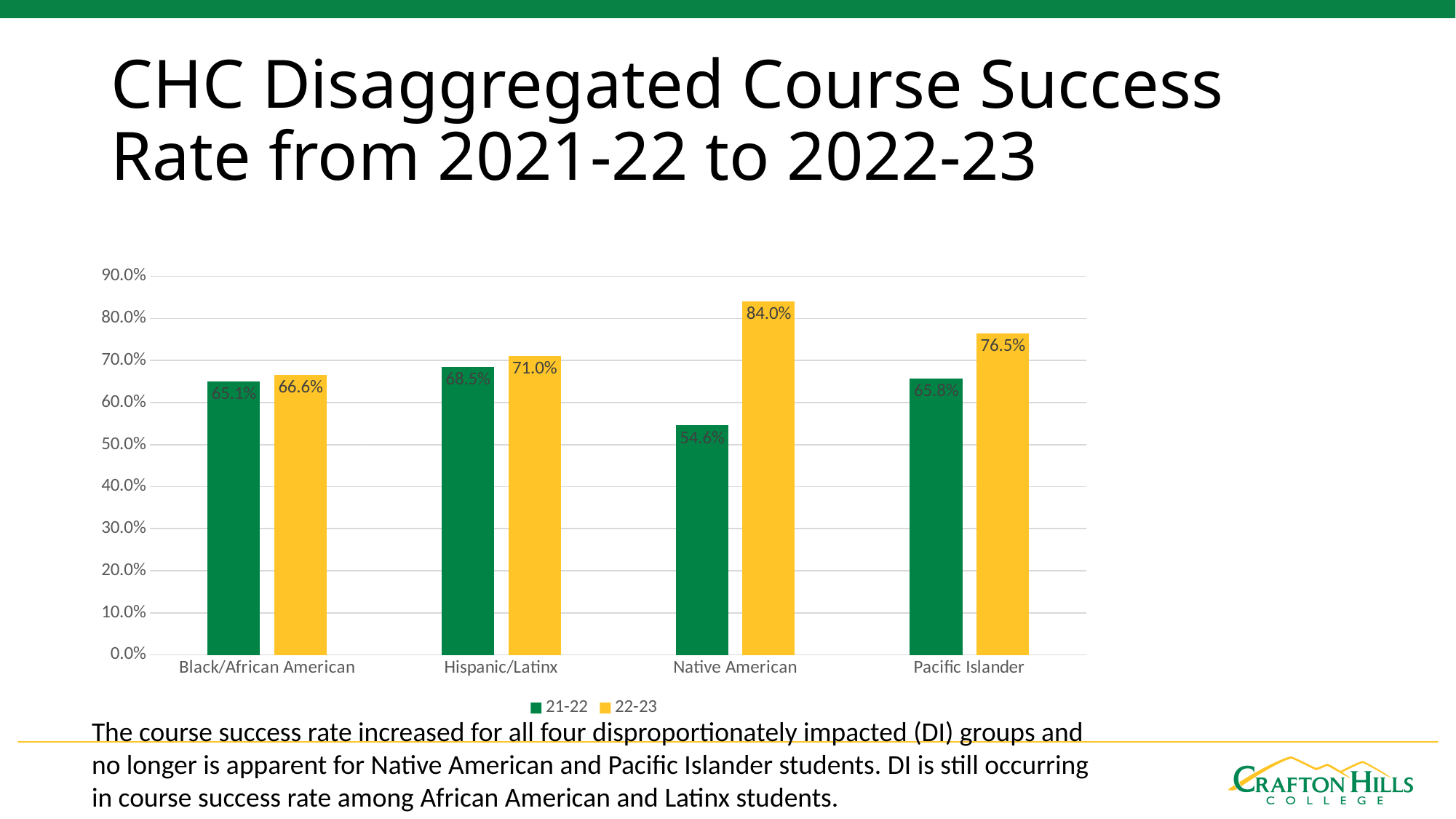
What is the 22-23 course success rate for Native American students? 84.0% What is the 22-23 course success rate for Pacific Islander students? 76.5% What is the 21-22 course success rate for Hispanic/Latinx students? 68.5% What is the difference between the 22-23 and 21-22 course success rates for Native American students? 29.4 percentage points Which group has the highest 22-23 course success rate? Native American How many series does the legend list? 2 What is the difference between the 22-23 and 21-22 course success rates for Pacific Islander students? 10.7 percentage points What kind of chart is shown on the slide? Bar chart Which group has the lowest 21-22 course success rate? Native American How many student groups are shown on the x axis? 4 Which is larger, the 22-23 rate for Hispanic/Latinx students or the 22-23 rate for Black/African American students? Hispanic/Latinx What is the 21-22 course success rate for Black/African American students? 65.1%